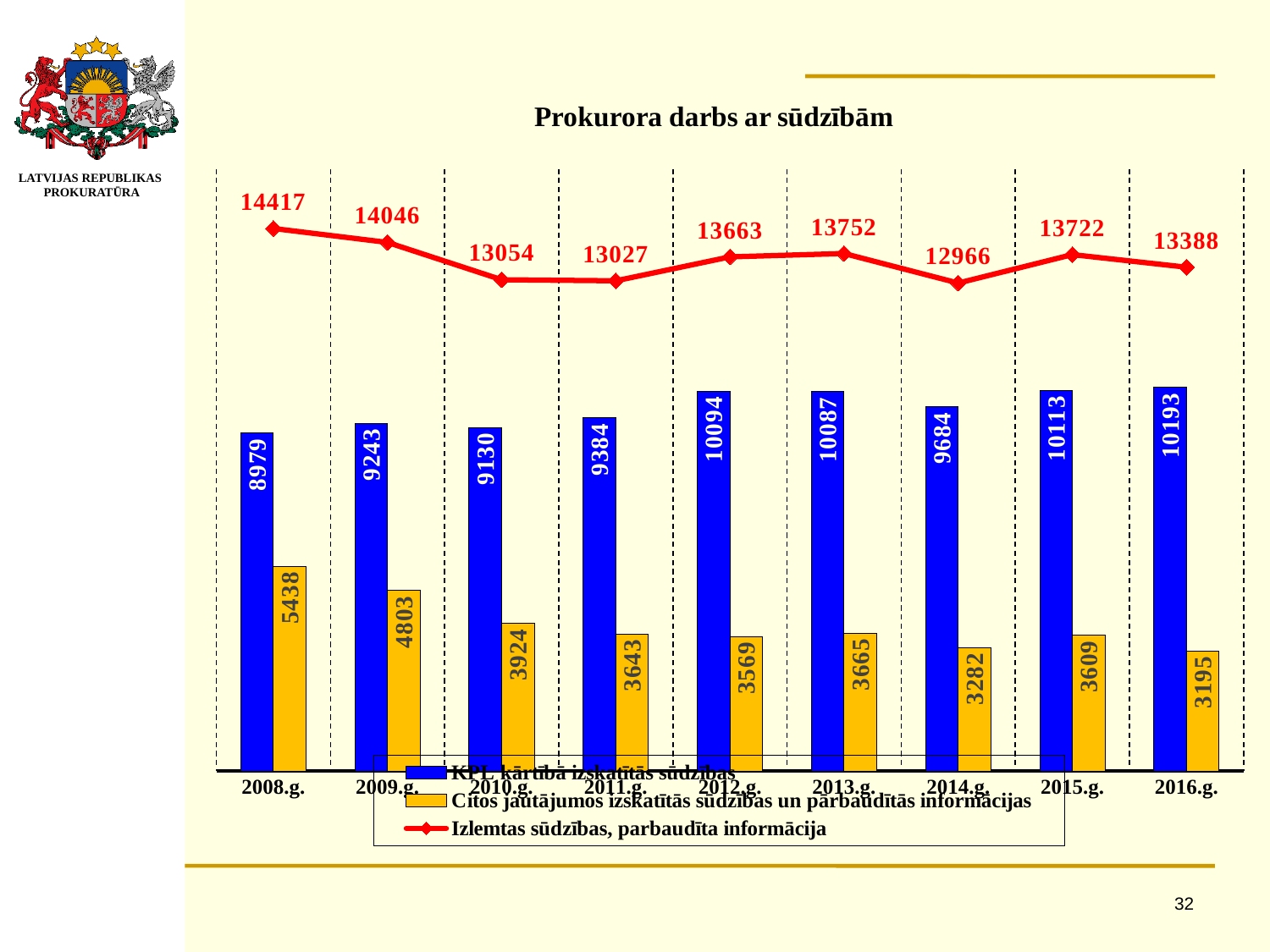
Which is larger: the blue bar for 2013.g. or the blue bar for 2014.g.? 2013.g. What is the value of the blue bars (KPL kārtībā izskatītās sūdzības) for 2012.g.? 10094 In which year is the blue bar (KPL kārtībā izskatītās sūdzības) highest? 2016.g. What is the difference between the yellow bar values for 2008.g. and 2016.g.? 2243 What is the value of the yellow bars (Citos jautājumos izskatītās sūdzības un pārbaudītās informācijas) for 2009.g.? 4803 In which year does the red line (Izlemtas sūdzības, pārbaudīta informācija) reach its highest value? 2008.g. What is the difference between the red line values for 2008.g. and 2009.g.? 371 How many series does the legend list? 3 In which year is the yellow bar (Citos jautājumos izskatītās sūdzības un pārbaudītās informācijas) lowest? 2016.g. What is the value of the red line (Izlemtas sūdzības, pārbaudīta informācija) for 2014.g.? 12966 Do the yellow bar values generally rise or fall from 2008.g. to 2016.g.? fall How many years are shown on the x axis of the chart? 9